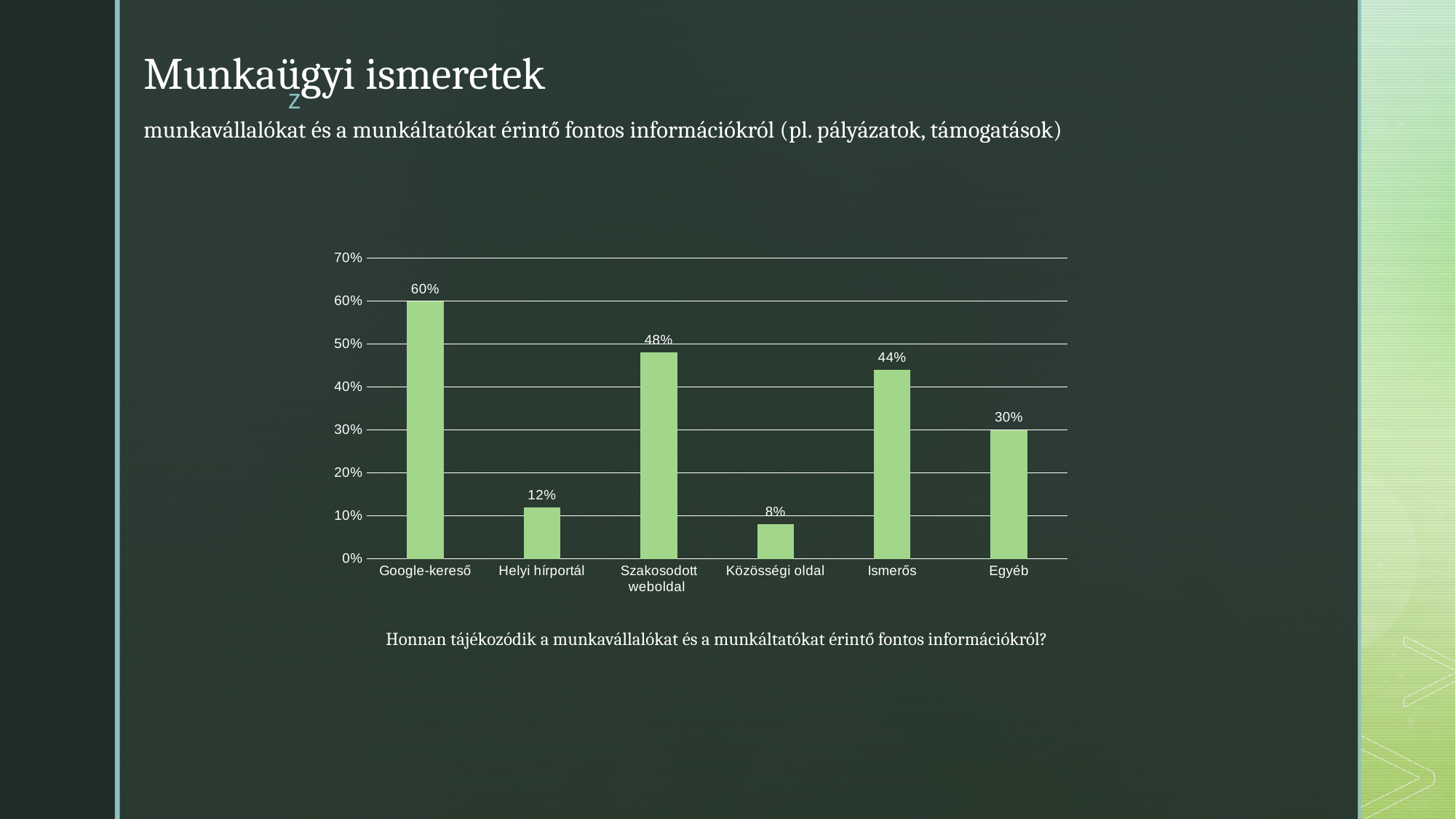
What is the difference between the values for Google-kereső and Egyéb? 30% What is the value for Helyi hírportál? 12% How many categories are shown on the x axis? 6 What question is written below the chart? Honnan tájékozódik a munkavállalókat és a munkáltatókat érintő fontos információkról? Which category has the lowest value? Közösségi oldal What kind of chart is shown on the slide? Bar chart What is the value for Közösségi oldal? 8% What is the value for Szakosodott weboldal? 48% Which category has the highest value? Google-kereső What is the value for Ismerős? 44% Which is larger, the value for Szakosodott weboldal or the value for Ismerős? Szakosodott weboldal What is the value for Google-kereső? 60%